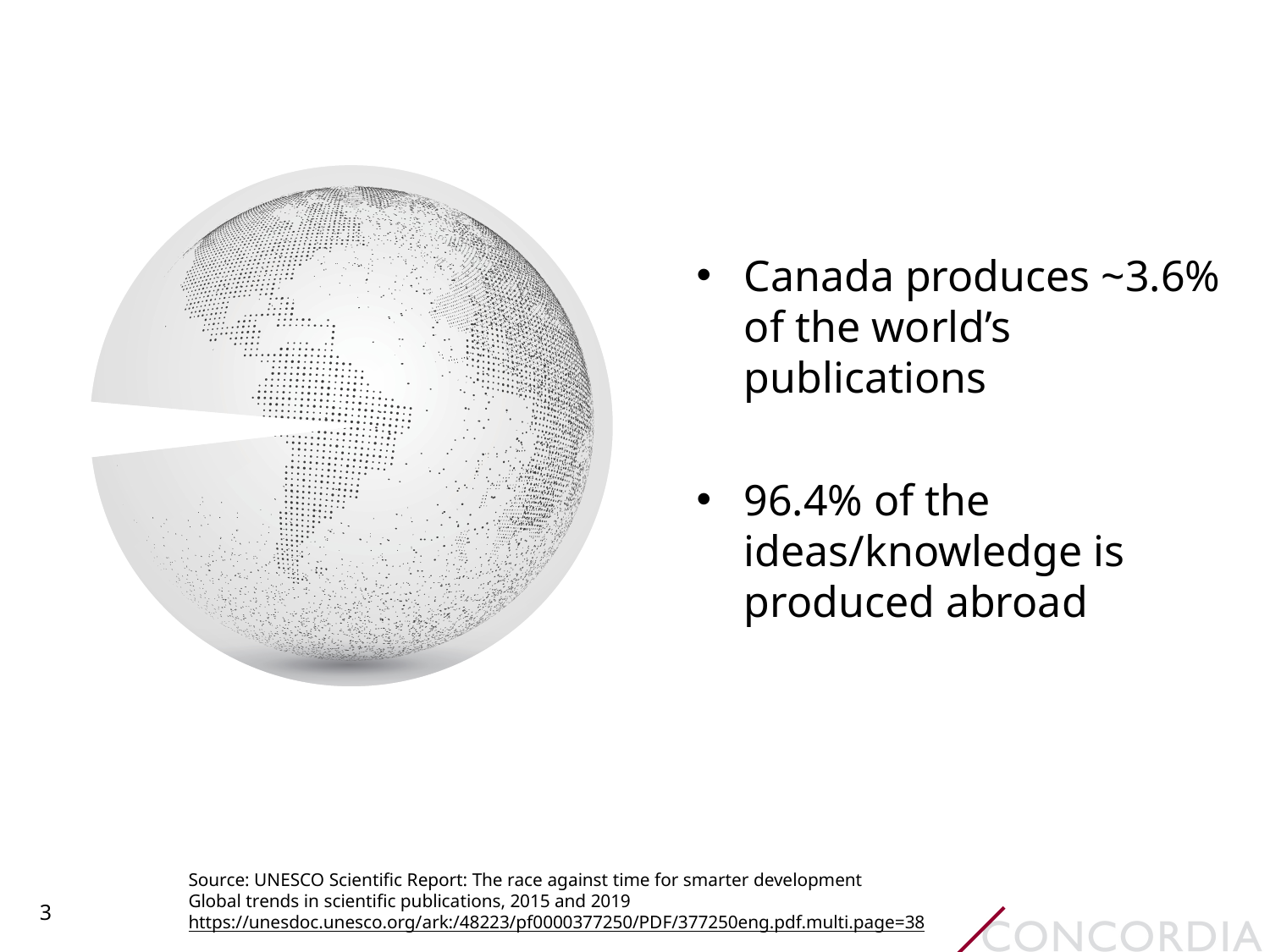
Is the share produced abroad greater or less than 50%? greater Which slice of the globe pie chart is larger: Canada's share or the share produced abroad? produced abroad What share of the ideas/knowledge is produced abroad, according to the slide? 96.4% What kind of chart is the globe graphic on the slide? pie chart Is Canada's share of the world's publications greater or less than 10%? less What is the source cited for the data on the slide? UNESCO Scientific Report: The race against time for smarter development How many slices does the globe pie chart have? 2 Which years does the cited data on global trends in scientific publications cover? 2015 and 2019 What share of the world's publications does Canada produce, according to the slide? ~3.6%